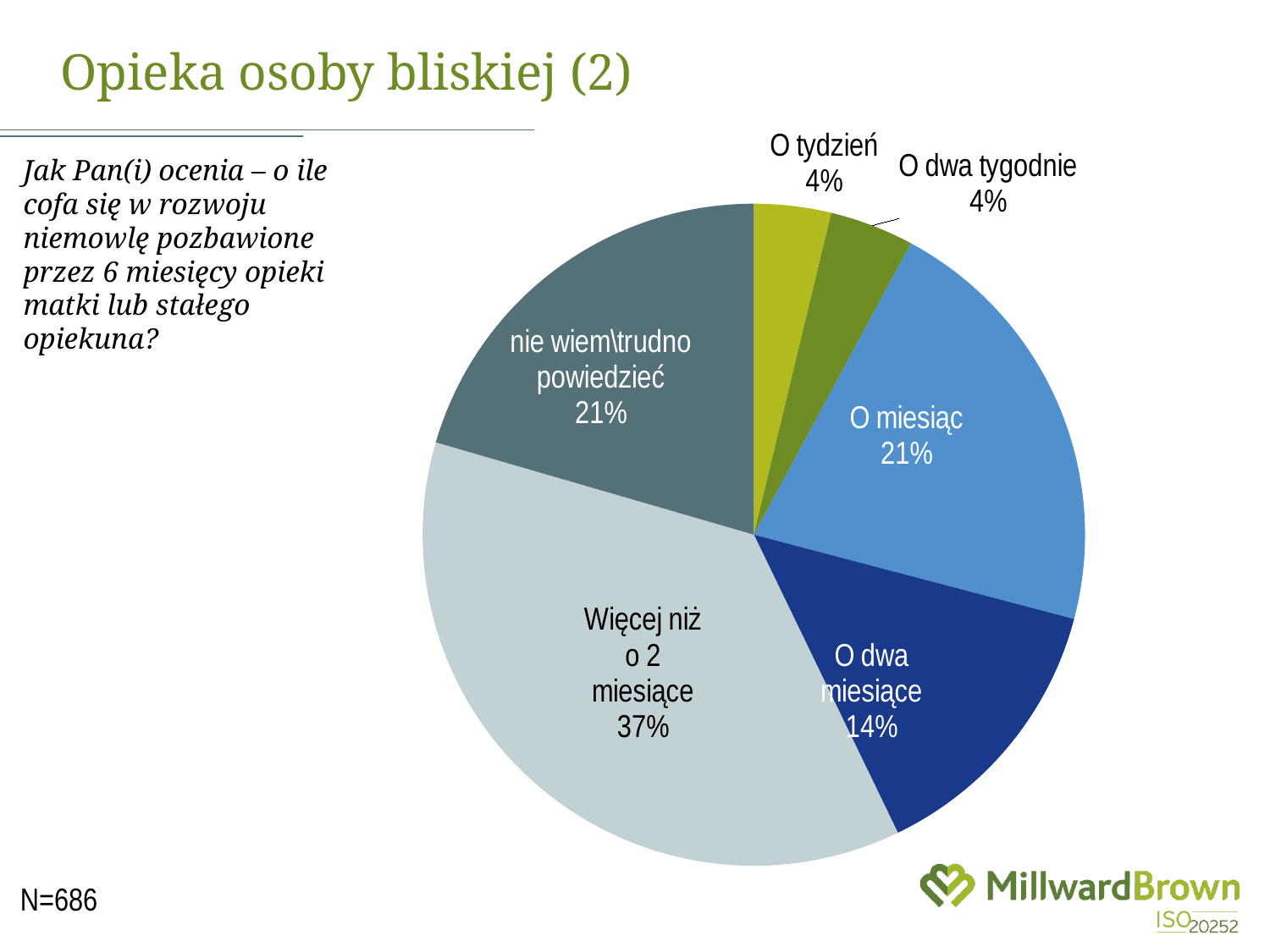
Which category has the largest share of the pie? Więcej niż o 2 miesiące What type of chart is shown on the slide? pie chart Which is larger, the share for "O miesiąc" or the share for "O dwa miesiące"? O miesiąc What percentage is shown for "Więcej niż o 2 miesiące"? 37% What is the title of the slide? Opieka osoby bliskiej (2) What is the sample size (N) shown on the slide? N=686 What percentage is shown for "O tydzień"? 4% How many slices does the pie chart have? 6 What percentage is shown for "O miesiąc"? 21% What is the difference in percentage points between "Więcej niż o 2 miesiące" and "O dwa miesiące"? 23 What percentage is shown for "O dwa miesiące"? 14% What percentage is shown for "nie wiem\trudno powiedzieć"? 21%